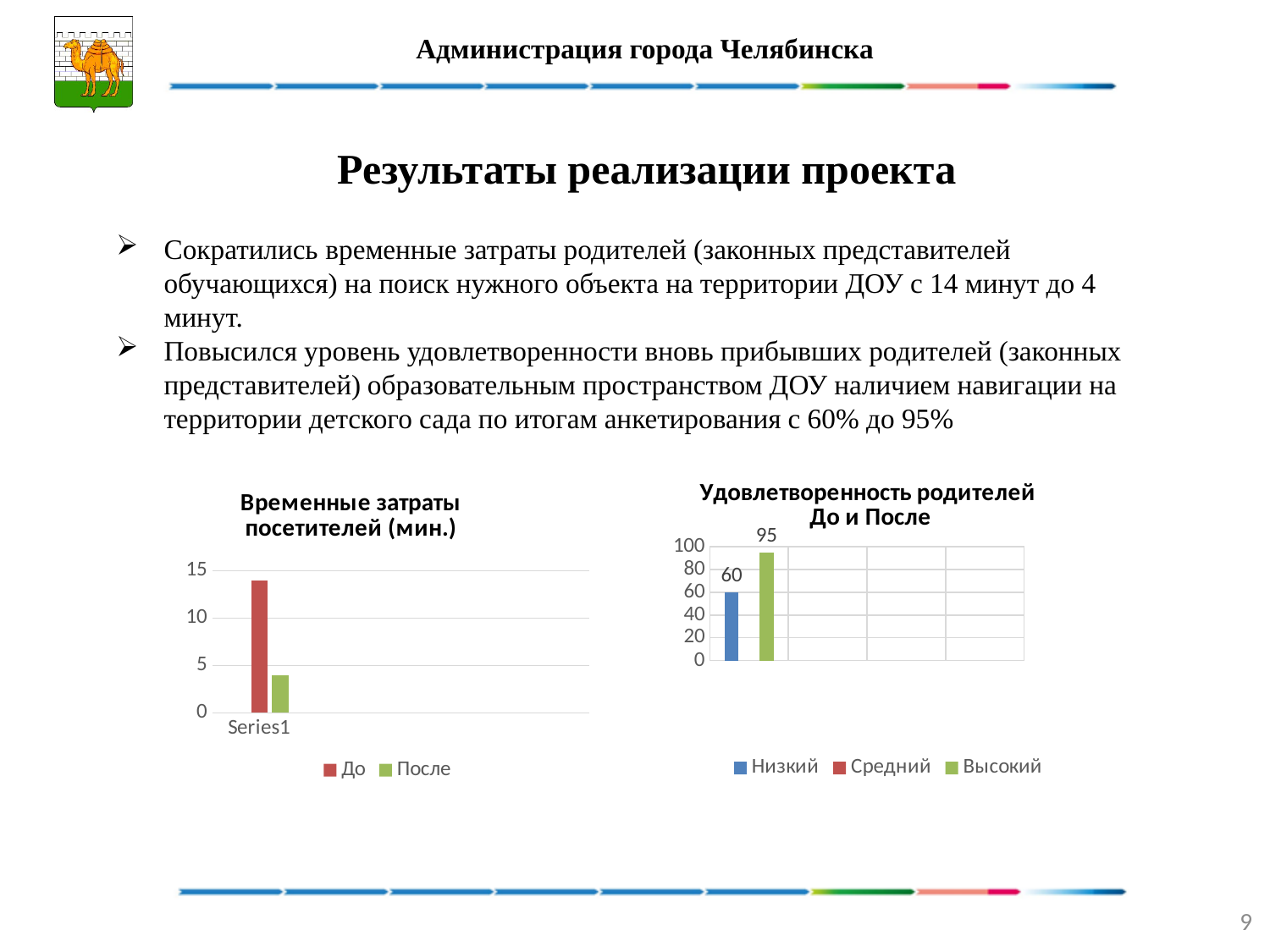
How many series does the legend of the chart titled "Временные затраты посетителей (мин.)" list? 2 In the chart titled "Удовлетворенность родителей До и После", what is the value of the bar labelled for the "Низкий" series? 60 What kind of chart is the chart titled "Временные затраты посетителей (мин.)"? Bar chart How many series does the legend of the chart titled "Удовлетворенность родителей До и После" list? 3 What kind of chart is the chart titled "Удовлетворенность родителей До и После"? Bar chart In the chart titled "Удовлетворенность родителей До и После", what is the difference between the two labelled bar values? 35 In the chart titled "Удовлетворенность родителей До и После", what is the value of the bar for the "Высокий" series? 95 In the chart titled "Удовлетворенность родителей До и После", which series has the taller bar, "Низкий" or "Высокий"? Высокий In the chart titled "Временные затраты посетителей (мин.)", what colour is the bar for the "После" series? Green In the chart titled "Временные затраты посетителей (мин.)", which series has the taller bar, "До" or "После"? До In the chart titled "Временные затраты посетителей (мин.)", is the value for "До" greater or less than 10? greater In the chart titled "Временные затраты посетителей (мин.)", is the value for "После" greater or less than 5? less